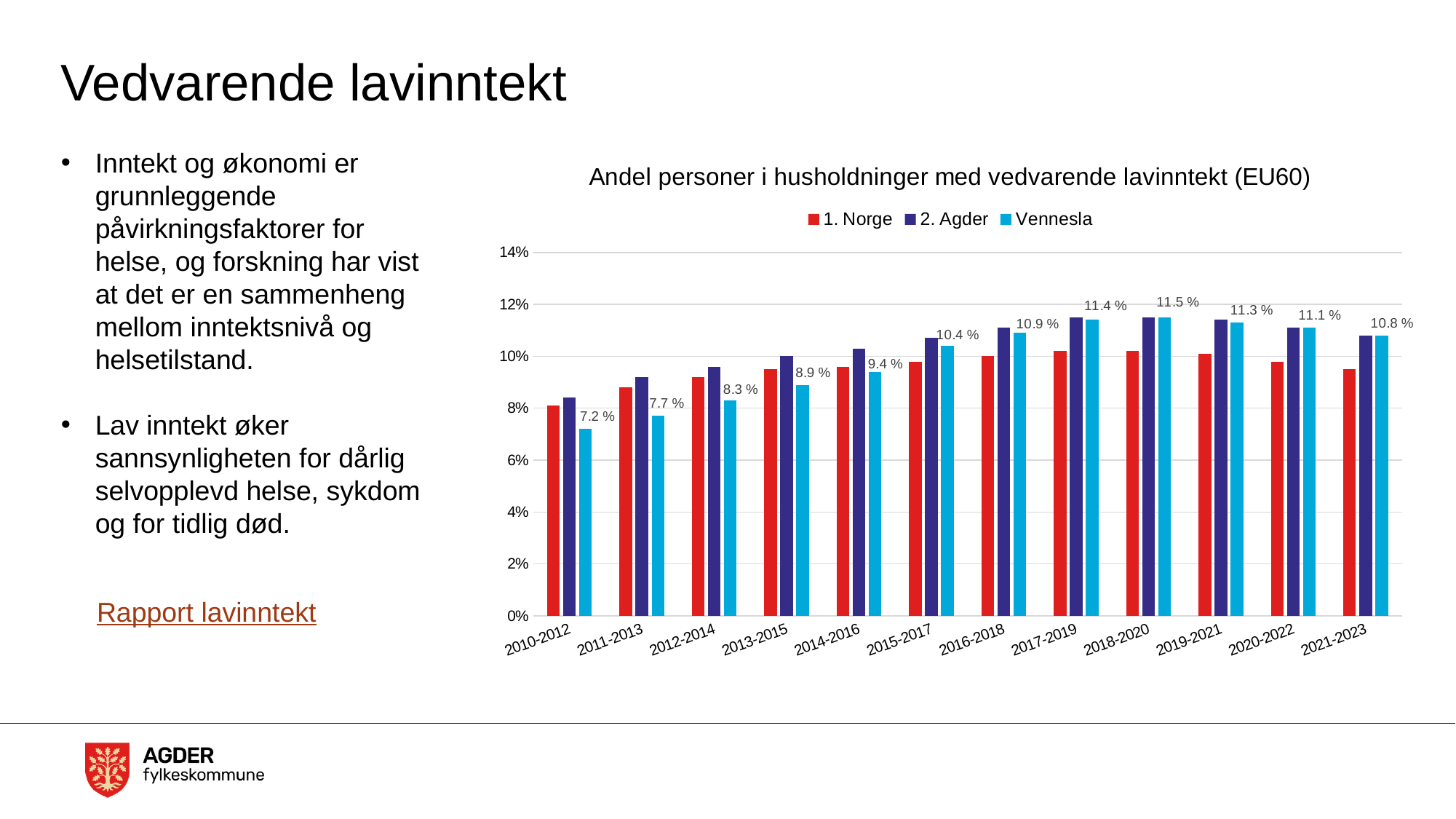
Is the value for 2. Agder in 2010-2012 greater or less than 10%? less Is the value for 1. Norge in 2017-2019 greater or less than 8%? greater How many periods are shown on the x axis? 12 How many series does the legend list? 3 In which period is the Vennesla value highest? 2018-2020 What is the value for Vennesla in 2021-2023? 10.8 % What is the difference between the Vennesla values for 2018-2020 and 2010-2012? 4.3 % In 2010-2012, which is larger: the value for 1. Norge or the value for Vennesla? 1. Norge In which period is the Vennesla value lowest? 2010-2012 What kind of chart is shown on the slide? Bar chart What is the value for Vennesla in 2010-2012? 7.2 % What is the value for Vennesla in 2018-2020? 11.5 %